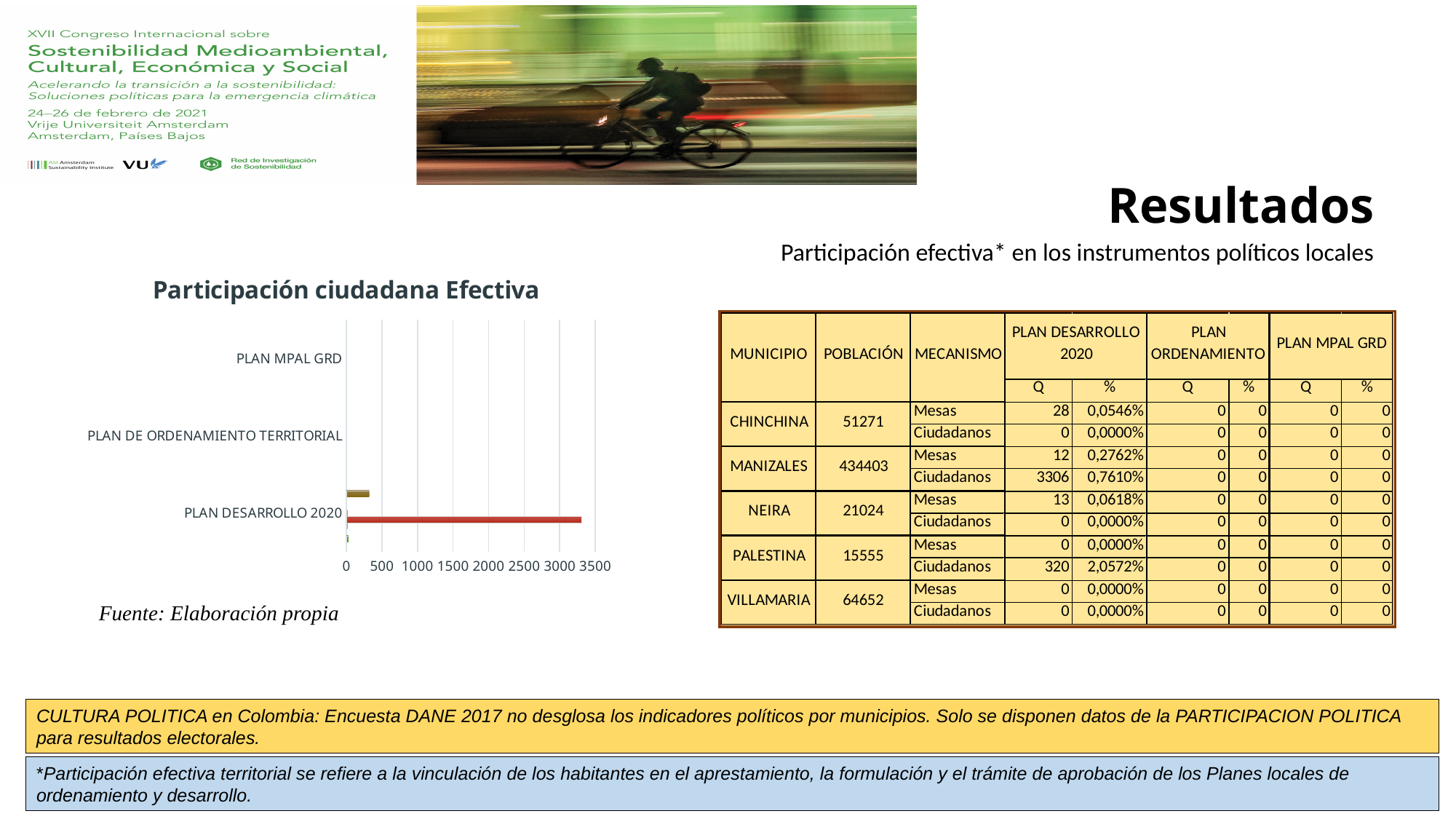
In the 'Participación ciudadana Efectiva' chart, is the longest bar for PLAN DESARROLLO 2020 greater or less than 3500? less Which category in the 'Participación ciudadana Efectiva' chart has the longest bar? PLAN DESARROLLO 2020 What kind of chart is 'Participación ciudadana Efectiva'? bar chart In the 'Participación ciudadana Efectiva' chart, is the longest bar for PLAN DESARROLLO 2020 greater or less than 3000? greater What is the title of the bar chart on the slide? Participación ciudadana Efectiva In the 'Participación ciudadana Efectiva' chart, is the olive-coloured bar for PLAN DESARROLLO 2020 greater or less than 500? less What is the highest tick value shown on the x axis of the 'Participación ciudadana Efectiva' chart? 3500 In the 'Participación ciudadana Efectiva' chart, which is larger: the red bar or the olive bar for PLAN DESARROLLO 2020? the red bar How many categories are shown on the y axis of the 'Participación ciudadana Efectiva' chart? 3